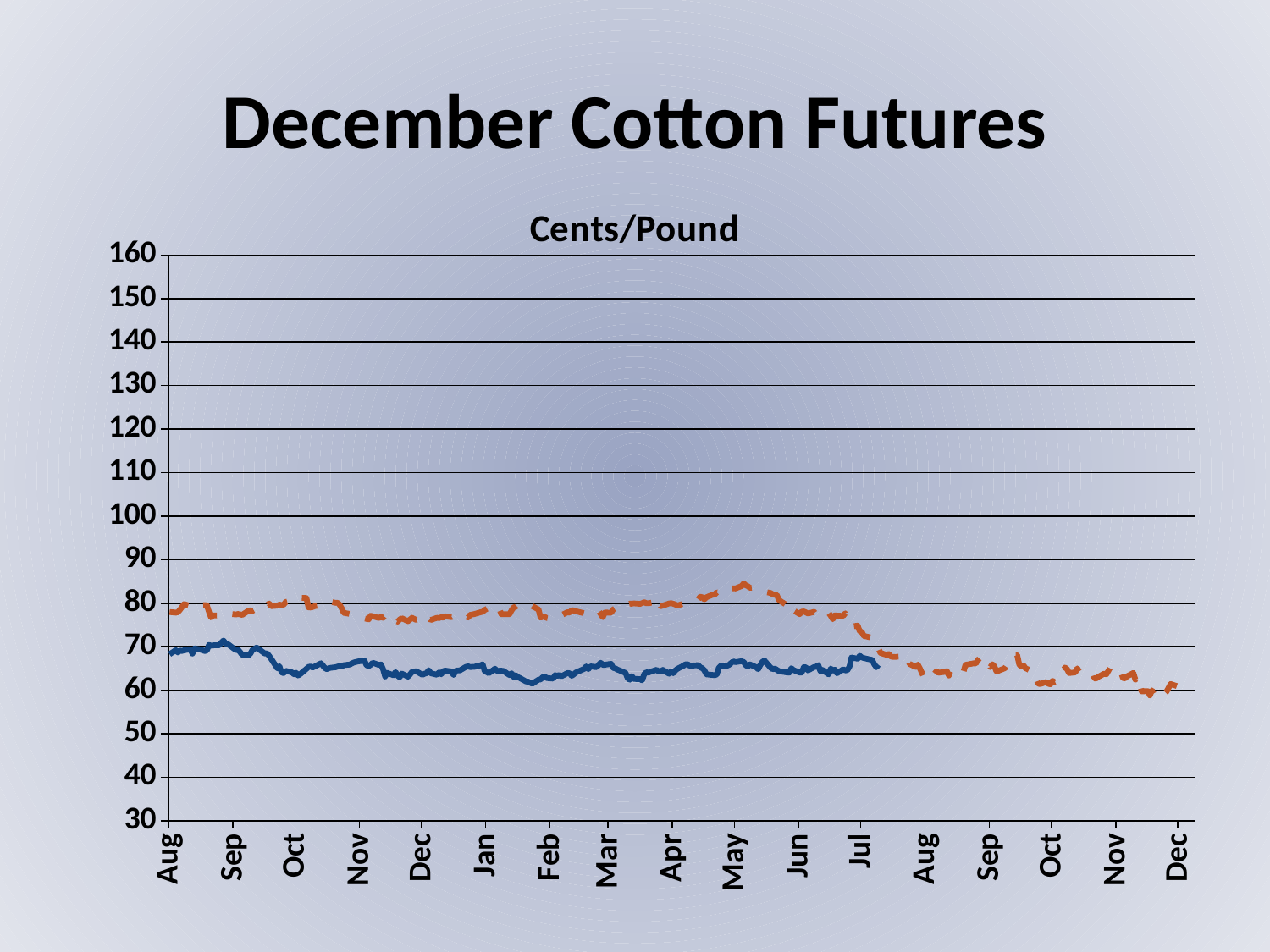
Is the peak of the dashed orange line in May greater or less than 80? greater Is the value of the dashed orange line at the final Dec greater or less than 70? less Does the dashed orange line rise or fall from Jul to the final Dec? fall How many month labels are shown along the x axis? 17 What is the title of the chart? Cents/Pound In the first Aug, which line is higher, the dashed orange line or the solid blue line? dashed orange line Is the value of the dashed orange line at the first Nov greater or less than 80? less What is the highest value shown on the y axis? 160 In which month does the dashed orange line reach its highest point? May What kind of chart is shown on the slide? line chart How many lines are plotted on the chart? 2